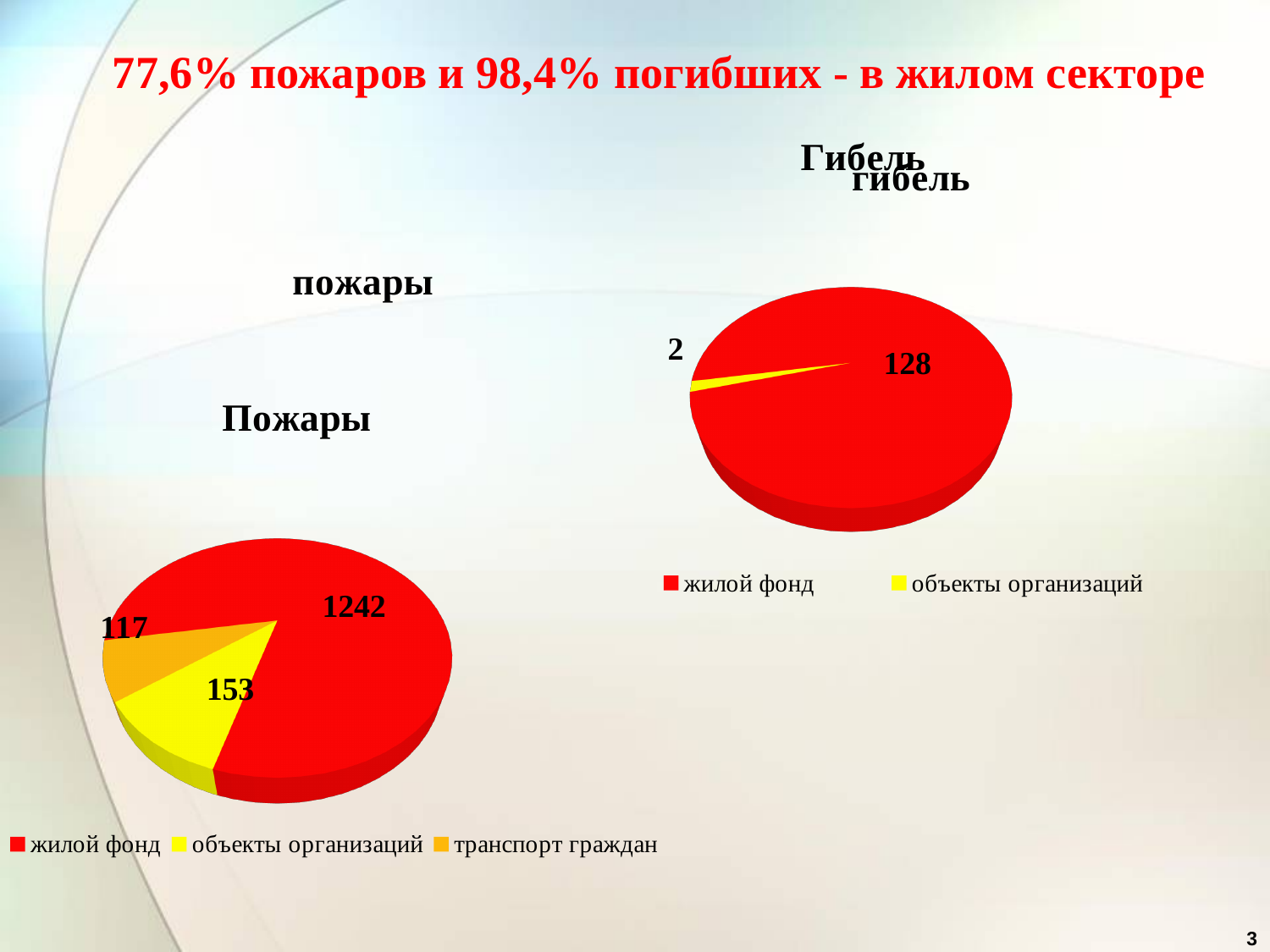
In the "Пожары" pie chart, what is the value for жилой фонд? 1242 In the "Пожары" pie chart, which category has the largest slice? жилой фонд In the "Пожары" pie chart, which category has the smallest slice? транспорт граждан In the "Гибель" pie chart on the right, what is the value for жилой фонд? 128 What type of chart is the "Пожары" chart on the left? pie chart How many slices does the "Пожары" pie chart have? 3 In the "Гибель" pie chart on the right, what is the value for объекты организаций? 2 In the "Пожары" pie chart, what is the value for транспорт граждан? 117 In the "Гибель" pie chart, what is the difference between жилой фонд and объекты организаций? 126 In the "Пожары" pie chart, what is the value for объекты организаций? 153 How many entries does the legend of the "Гибель" pie chart list? 2 In the "Пожары" pie chart, what is the difference between объекты организаций and транспорт граждан? 36